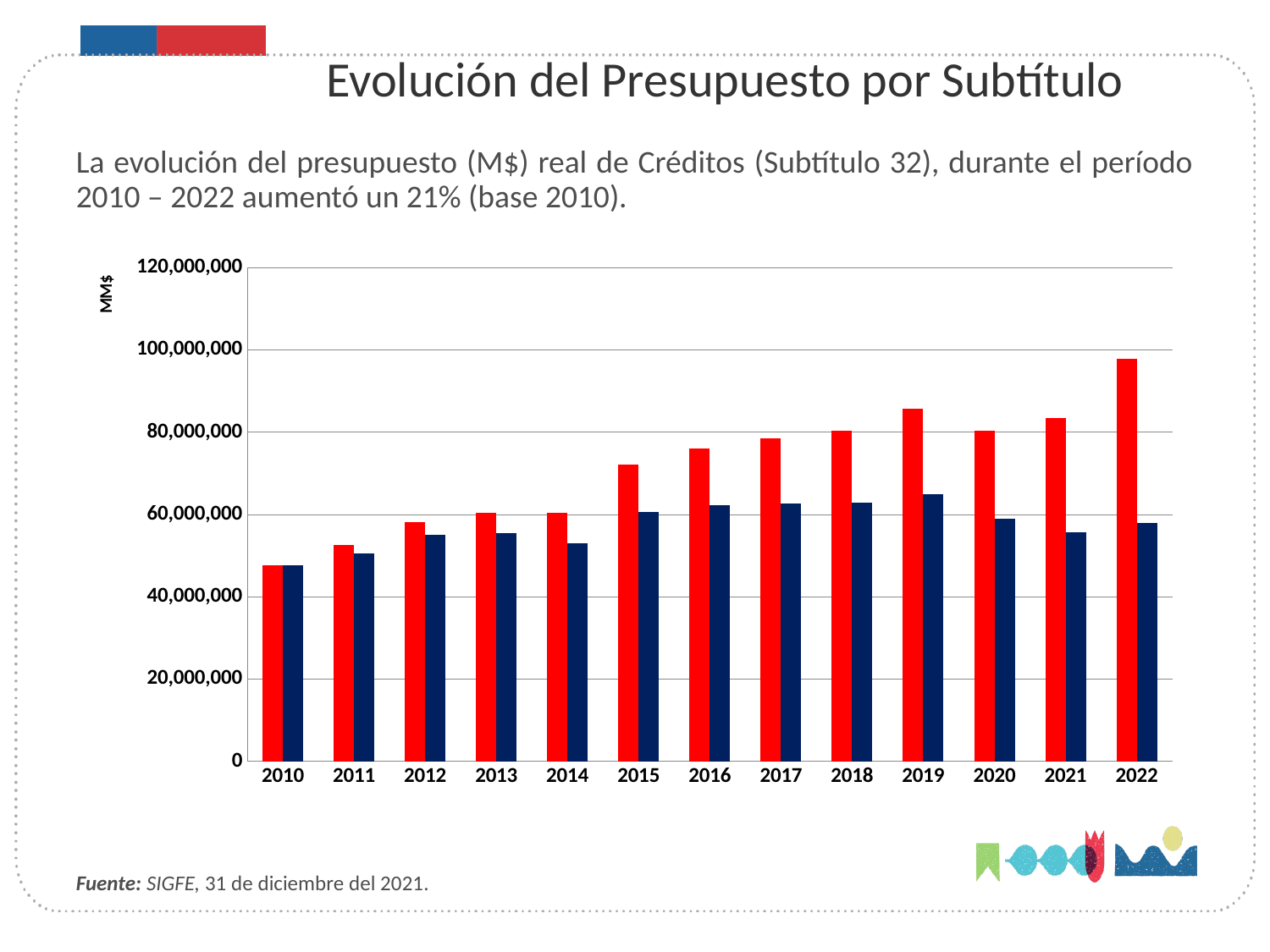
How many years are shown on the x axis of the chart? 13 Do the red bars generally rise or fall from 2010 to 2022? Rise What unit label is shown on the vertical axis of the chart? MM$ Which year has the shortest red bar? 2010 Is the value of the dark blue bar for 2014 greater or less than 60,000,000? less Is the value of the red bar for 2015 greater or less than 60,000,000? greater In 2022, which bar is larger, the red bar or the dark blue bar? The red bar Is the value of the red bar for 2022 greater or less than 80,000,000? greater What kind of chart is shown on the slide? Bar chart Which year has the tallest red bar? 2022 Which year has the tallest dark blue bar? 2019